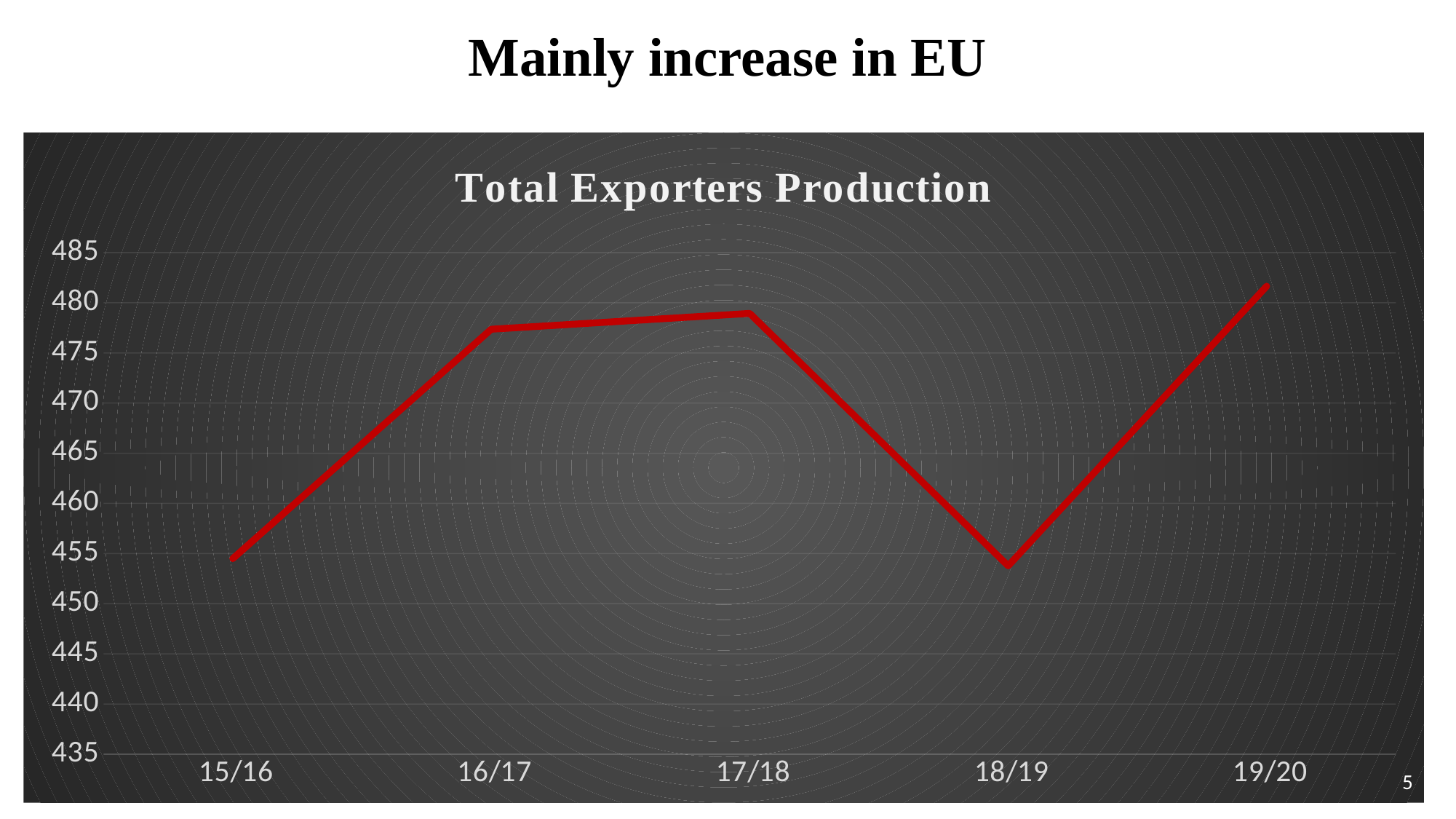
Is the value for 19/20 greater or less than 475? greater Which season has the highest Total Exporters Production? 19/20 Which is larger, the value for 16/17 or the value for 15/16? 16/17 What kind of chart is shown on the slide? line chart Is the value for 17/18 greater or less than 475? greater Which is larger, the value for 17/18 or the value for 18/19? 17/18 How many points (seasons) are plotted on the x axis? 5 Does the line rise or fall from 17/18 to 18/19? fall Is the value for 18/19 greater or less than 460? less What colour is the plotted line? red What is the title of the chart? Total Exporters Production